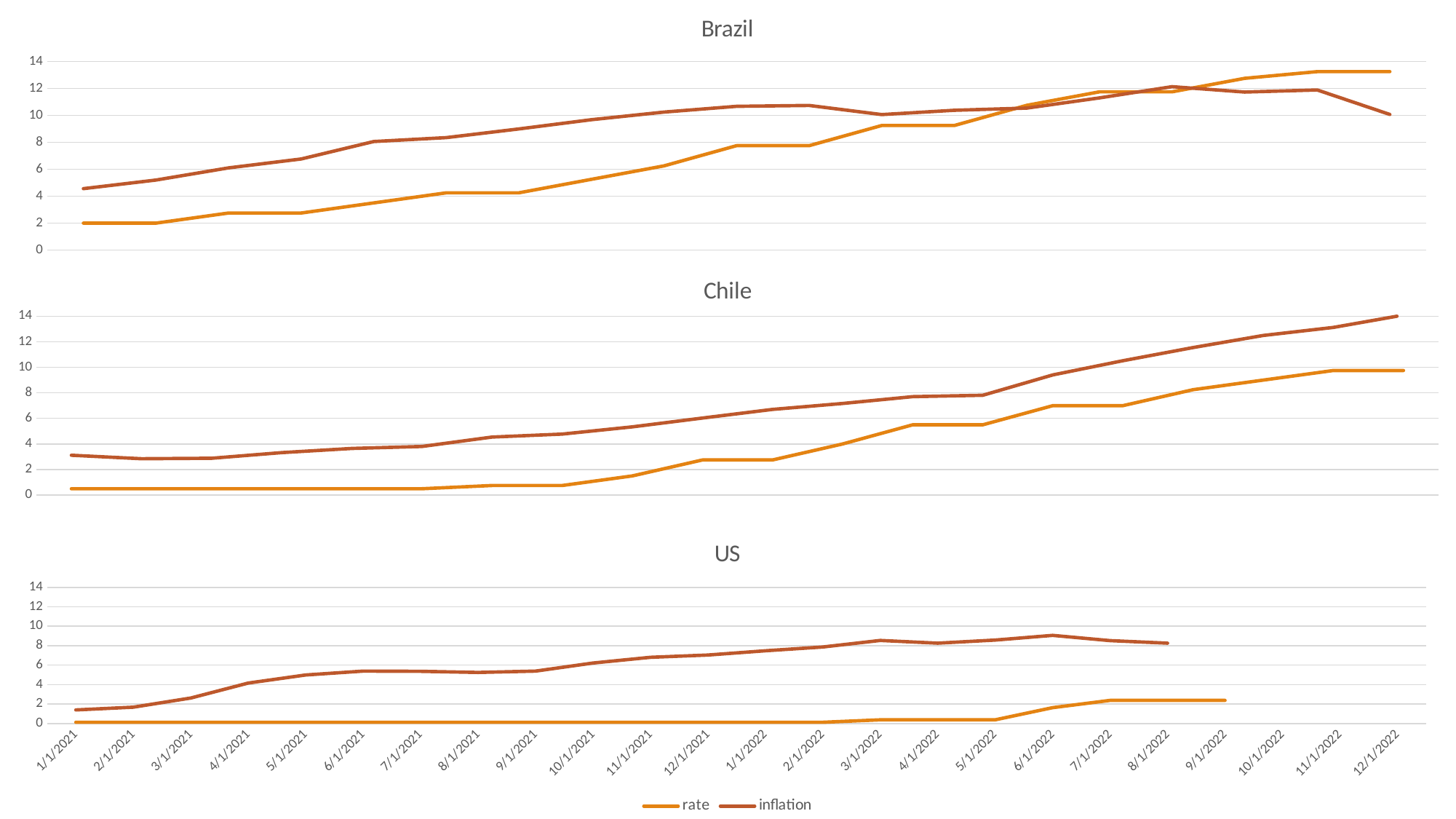
In the Chile chart, does the rate series rise or fall along the x axis? rise In the Brazil chart, is the value for rate at 12/1/2022 greater or less than 12? greater What are the two series named in the legend? rate and inflation In the Brazil chart, is the value for inflation at 1/1/2021 greater or less than 6? less In the Chile chart, at which date is inflation highest? 12/1/2022 In the Brazil chart, which series is larger at 1/1/2021, rate or inflation? inflation How many series does the legend list? 2 In the Brazil chart, which series is larger at 12/1/2022, rate or inflation? rate In the US chart, is the value for inflation at 6/1/2022 greater or less than 8? greater How many dates are shown along the x axis? 24 In the Chile chart, which series is larger at 12/1/2022, rate or inflation? inflation What kind of chart is the Brazil chart? line chart